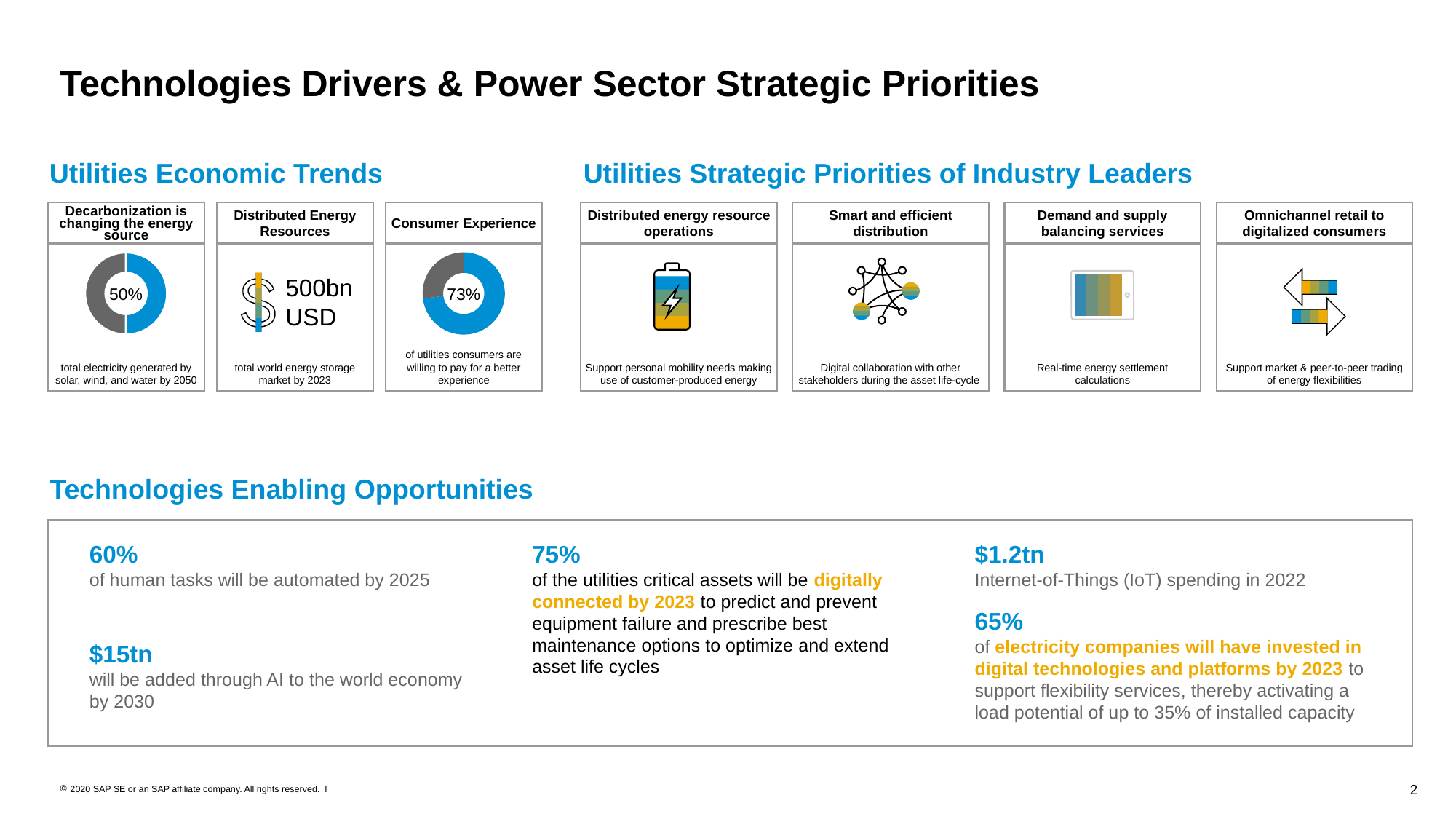
In the 'Decarbonization is changing the energy source' donut chart, what percentage is shown in the centre? 50% What is the difference between the percentage in the 'Consumer Experience' donut chart and the percentage in the 'Decarbonization' donut chart? 23 percentage points In the 'Consumer Experience' donut chart, what percentage is shown in the centre? 73% In the 'Consumer Experience' donut chart, what share of the ring is the grey (remaining) segment? 27% Which shows the larger percentage: the 'Decarbonization' donut chart or the 'Consumer Experience' donut chart? Consumer Experience According to the caption under the 'Decarbonization' donut chart, what does the 50% represent? Total electricity generated by solar, wind, and water by 2050 What kind of chart is used under 'Decarbonization is changing the energy source' and 'Consumer Experience'? Donut (pie) chart In the 'Consumer Experience' donut chart, is the highlighted value greater or less than 50%? greater What colour is the highlighted segment in the 'Consumer Experience' donut chart? Blue How many donut charts are shown in the 'Utilities Economic Trends' section? 2 How many segments does each donut chart in the 'Utilities Economic Trends' section have? 2